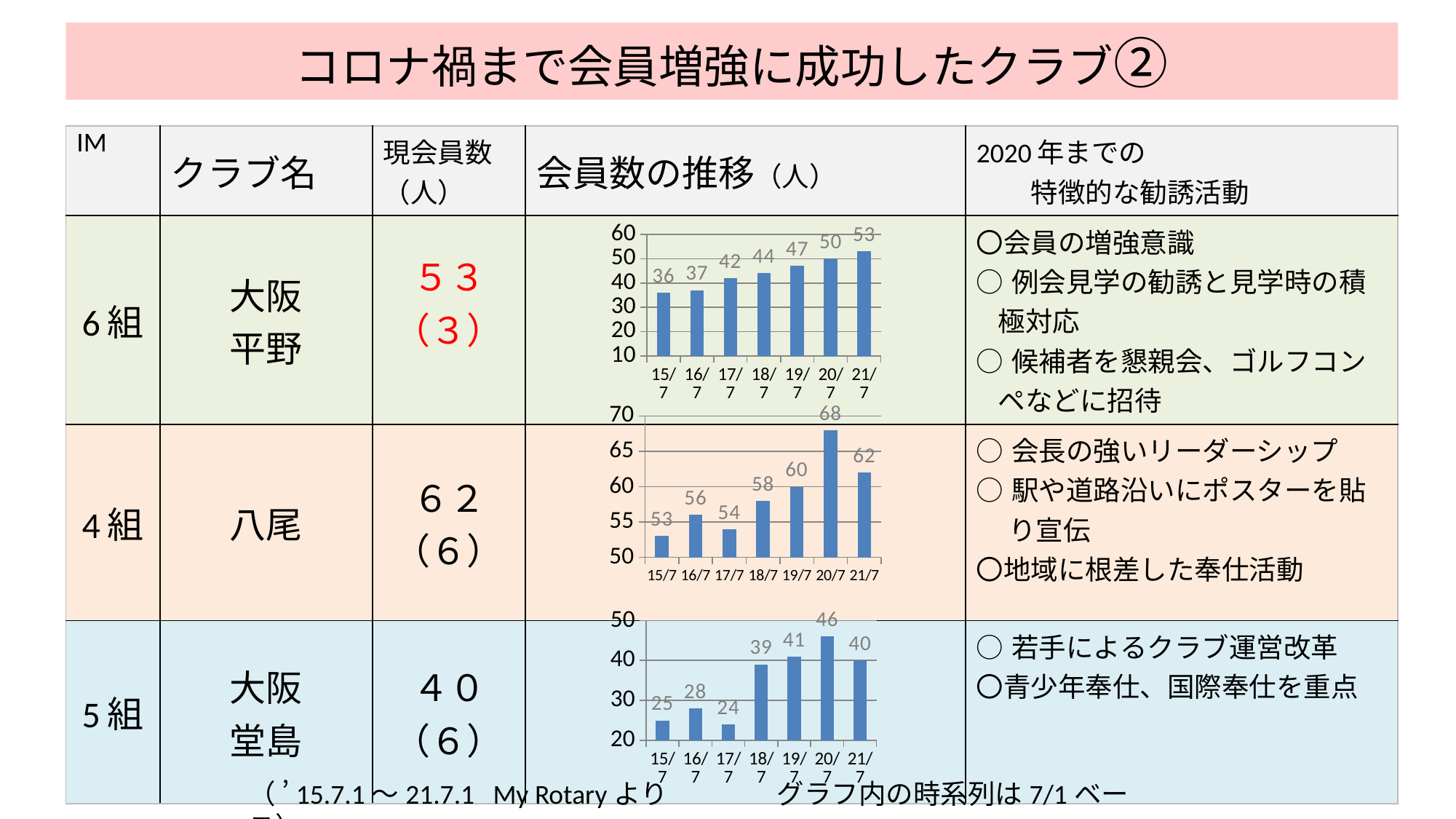
In the middle chart (八尾), which is larger, the value for 16/7 or 17/7? 16/7 How many bars are in the bottom chart (大阪堂島)? 7 In the bottom chart (大阪堂島), what is the value for 20/7? 46 In the middle chart (八尾), what is the difference between the values for 20/7 and 21/7? 6 In the bottom chart (大阪堂島), what is the difference between the values for 18/7 and 17/7? 15 In the middle chart (八尾), which period has the highest value? 20/7 In the top chart (大阪平野), what is the value for 21/7? 53 In the middle chart (八尾), what is the value for 18/7? 58 In the top chart (大阪平野), what is the value for 15/7? 36 In the bottom chart (大阪堂島), which period has the lowest value? 17/7 In the top chart (大阪平野), do the values rise or fall from 15/7 to 21/7? rise What type of chart is used for the top chart (大阪平野)? bar chart